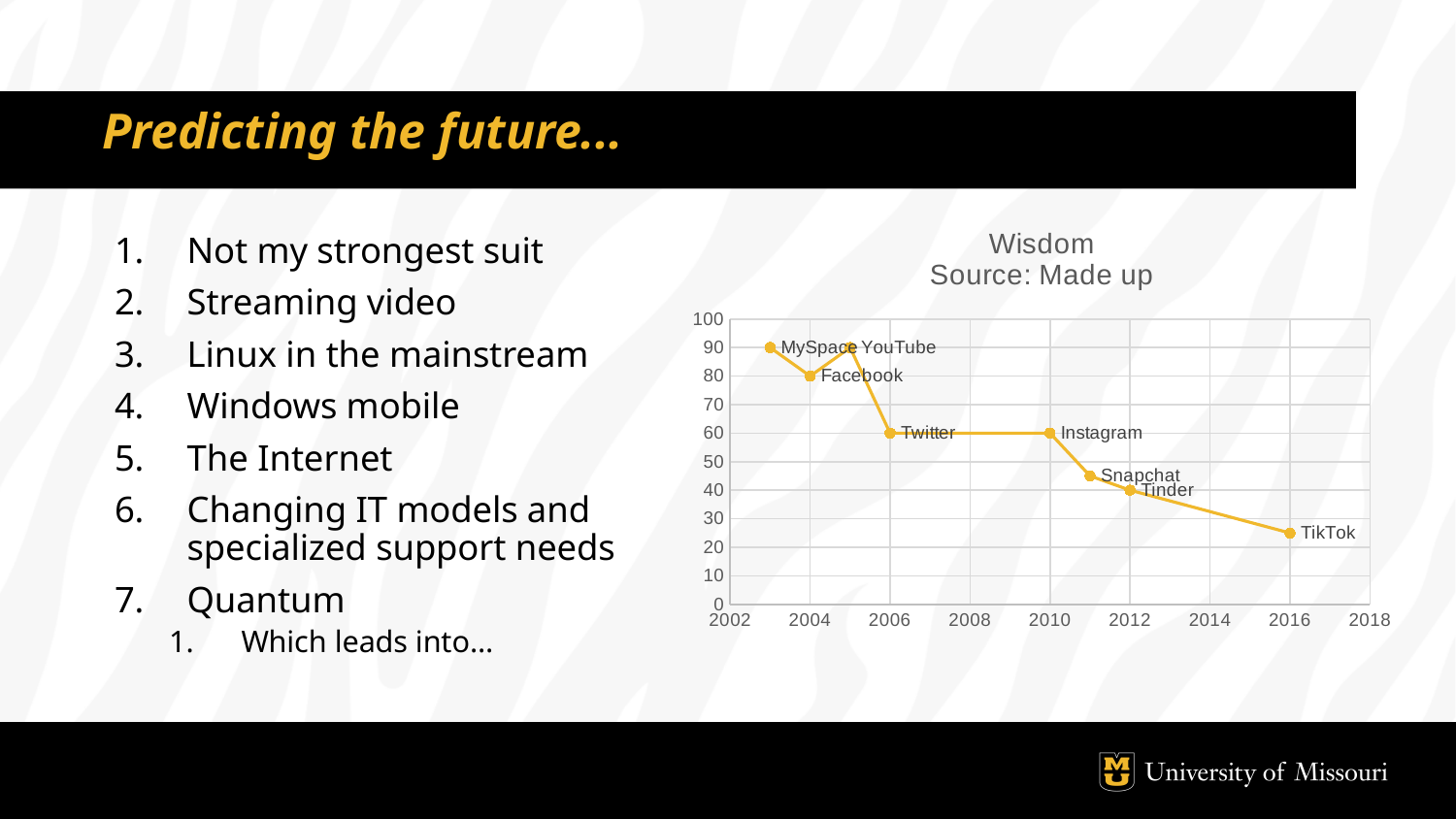
What is the title of the chart? Wisdom Source: Made up What kind of chart is shown on the slide? line chart Which has the larger value, Instagram or Tinder? Instagram Is the value for Snapchat greater or less than 40? greater Which has the larger value, Facebook or Twitter? Facebook What is the value plotted for Twitter? 60 Do the values generally rise or fall from left to right along the x axis? fall Is the value for Snapchat greater or less than 50? less Is the value for TikTok greater or less than 30? less Which labeled point has the lowest value on the chart? TikTok What is the value plotted for Facebook? 80 How many labeled data points are plotted on the chart? 8